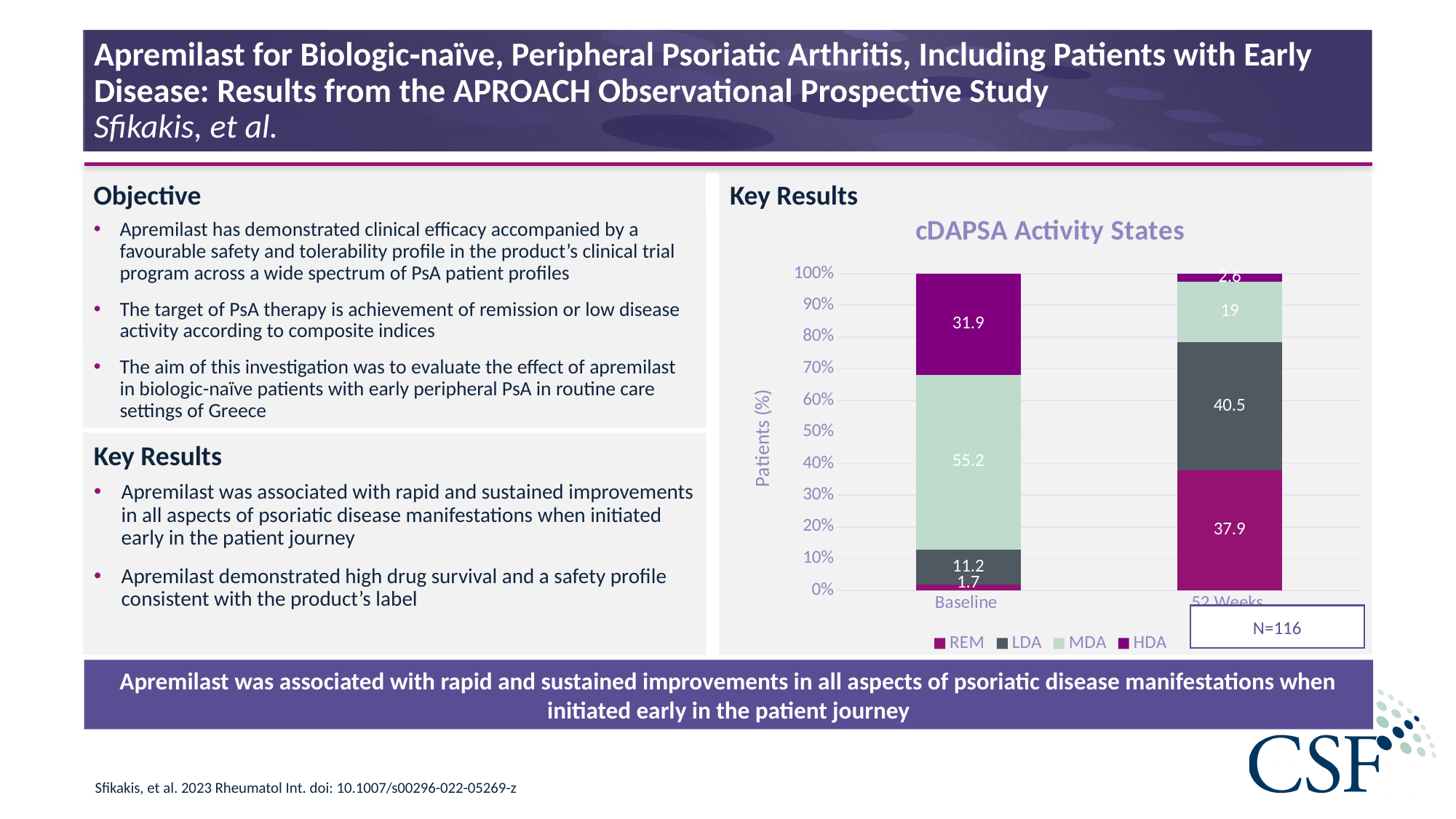
Is the HDA value larger at Baseline or at 52 Weeks? Baseline Which activity state has the largest share at Baseline? MDA Which activity state has the smallest share at 52 Weeks? HDA What is the HDA value at Baseline? 31.9 By how much does the REM value increase from Baseline to 52 Weeks? 36.2 What kind of chart is shown under Key Results? Stacked bar chart How many categories are shown on the x axis of the chart? 2 What is the title of the chart? cDAPSA Activity States What is the MDA value at Baseline? 55.2 What is the LDA value at 52 Weeks? 40.5 How many series does the chart legend list? 4 What is the REM value at 52 Weeks? 37.9